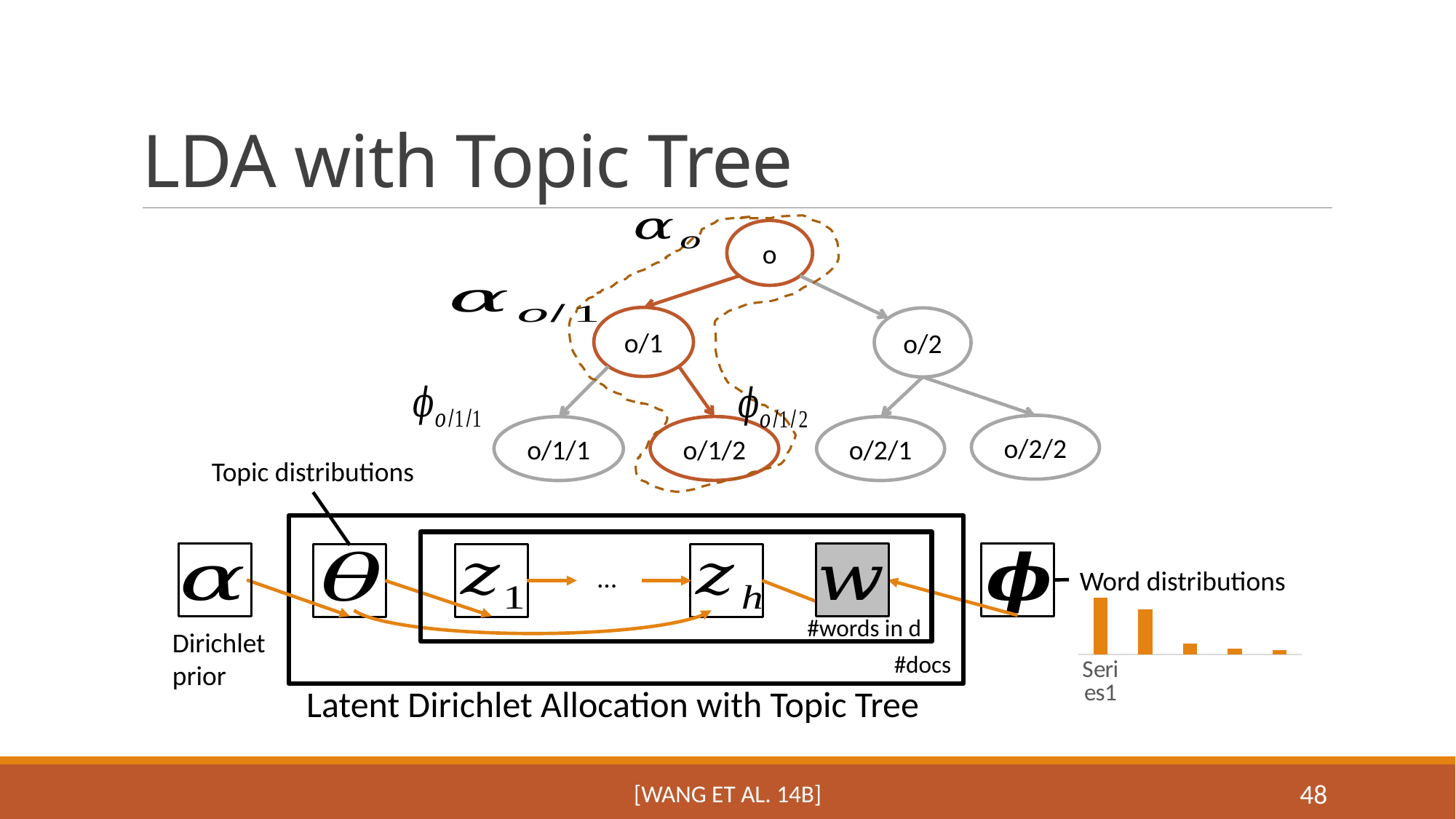
How many bars does the small bar chart at the bottom right of the slide contain? 5 In the small bar chart at the bottom right, which bar is the tallest? the first (leftmost) bar In the small bar chart at the bottom right, do the bar heights rise or fall from left to right? fall What colour are the bars in the small bar chart at the bottom right of the slide? orange In the small bar chart at the bottom right, is the first bar or the third bar taller? the first bar What kind of chart is shown at the bottom right of the slide, next to the word distributions label? bar chart In the small bar chart at the bottom right, is the second bar or the fourth bar taller? the second bar